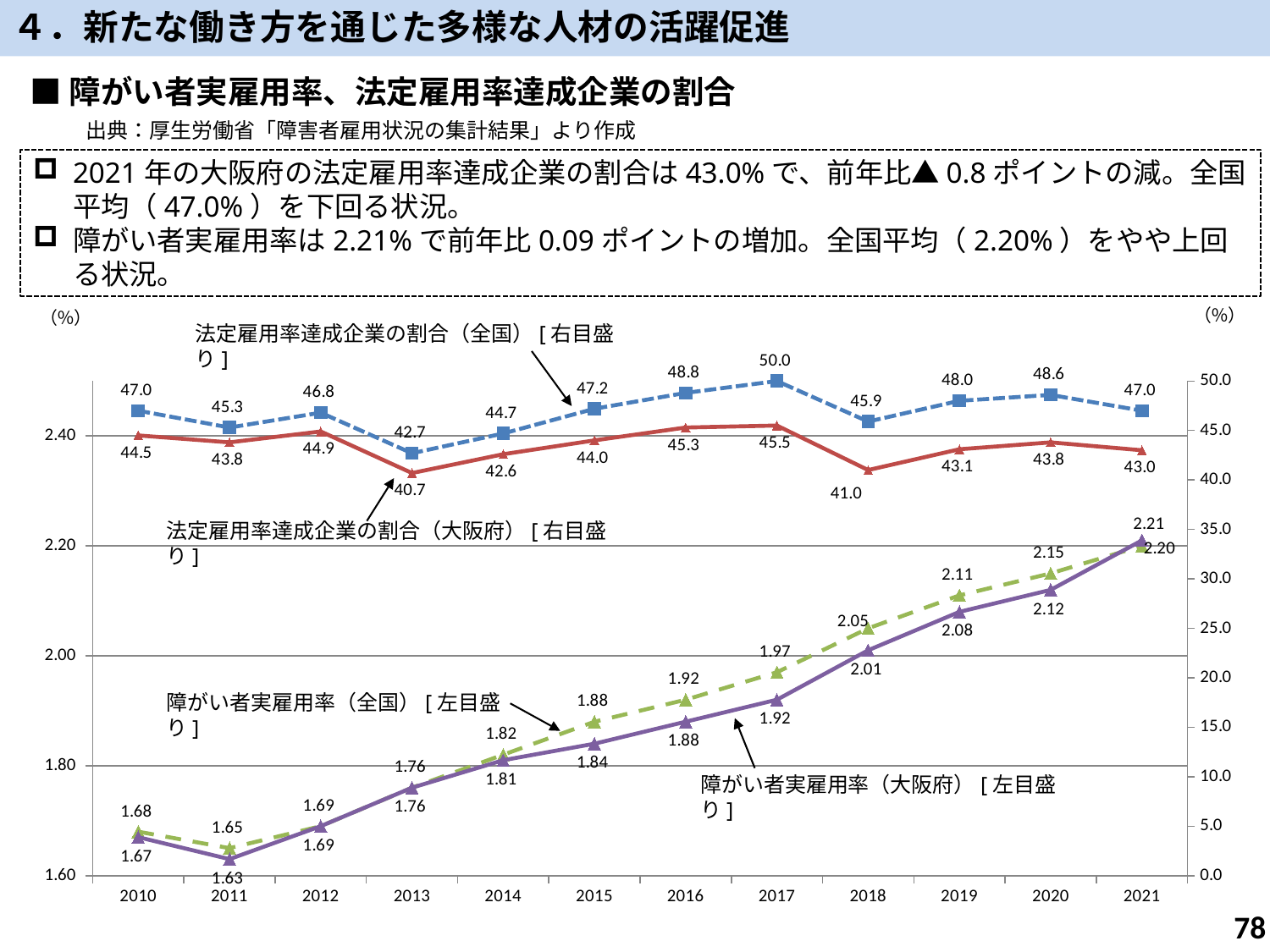
2020年の法定雇用率達成企業の割合（大阪府）は45.0より大きいですか、小さいですか？ 小さい 2021年の障がい者実雇用率（大阪府）の値はいくつですか？ 2.21 障がい者実雇用率（大阪府）が最も低いのは何年ですか？ 2011 障がい者実雇用率（全国）は2011年から2021年にかけて上昇していますか、下降していますか？ 上昇 2013年の法定雇用率達成企業の割合（大阪府）の値はいくつですか？ 40.7 法定雇用率達成企業の割合（全国）が最も高いのは何年ですか？ 2017 2017年の法定雇用率達成企業の割合（全国）の値はいくつですか？ 50.0 このグラフには何本の系列が描かれていますか？ 4 2018年の障がい者実雇用率は、全国と大阪府のどちらが高いですか？ 全国 2021年の法定雇用率達成企業の割合について、全国と大阪府の差は何ポイントですか？ 4.0 このグラフには何年分のデータ点がありますか？ 12 このグラフの種類は何ですか？ 折れ線グラフ